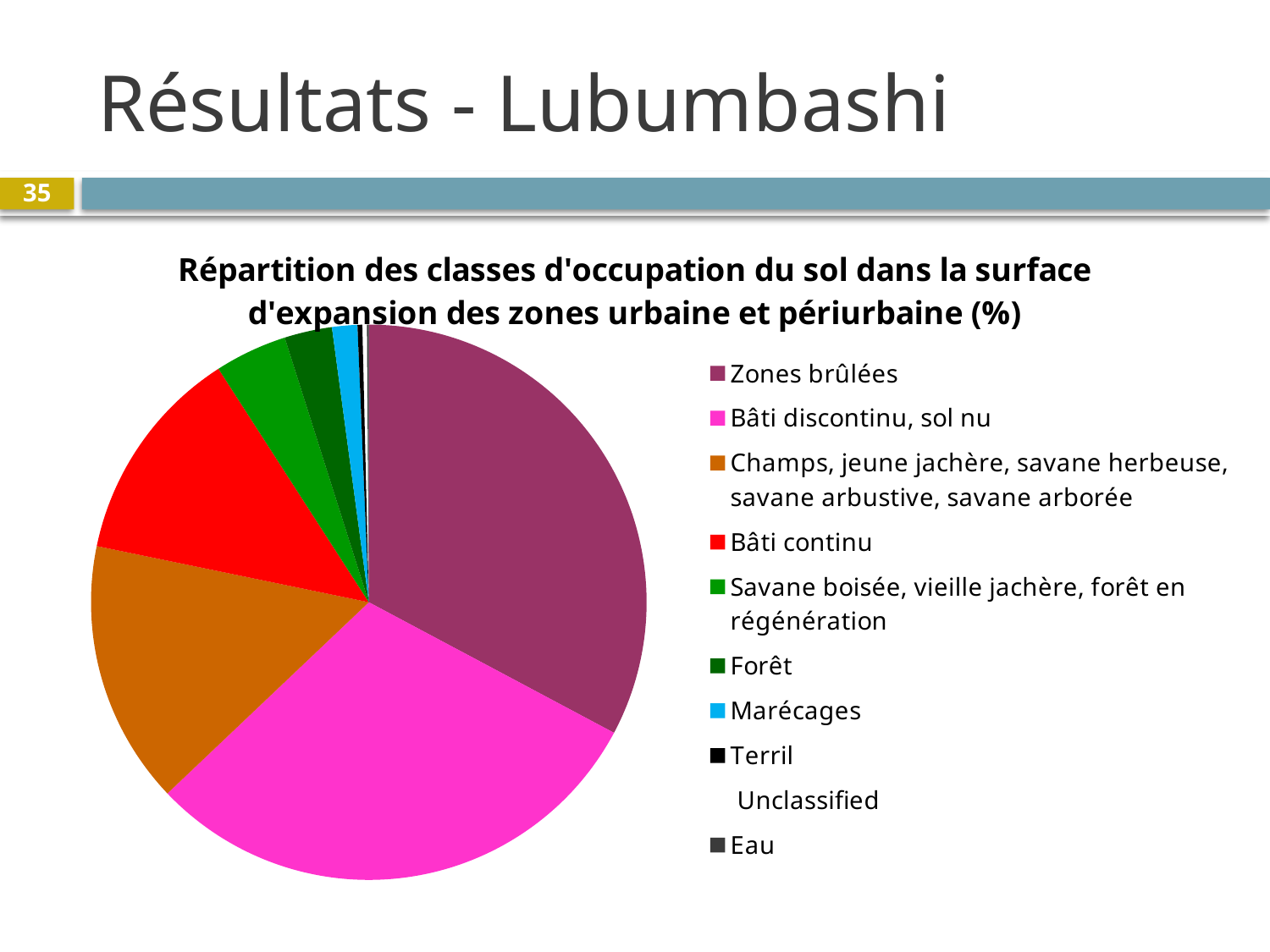
How many categories does the legend of the pie chart list? 10 What is the title of the pie chart? Répartition des classes d'occupation du sol dans la surface d'expansion des zones urbaine et périurbaine (%) Which slice is larger, Bâti discontinu, sol nu or Savane boisée, vieille jachère, forêt en régénération? Bâti discontinu, sol nu Which slice is larger, Marécages or Bâti discontinu, sol nu? Bâti discontinu, sol nu What kind of chart is shown on the slide? pie chart What colour is the Bâti continu slice in the pie chart? red Which slice is larger, Zones brûlées or Bâti continu? Zones brûlées Which category has the largest slice of the pie chart? Zones brûlées